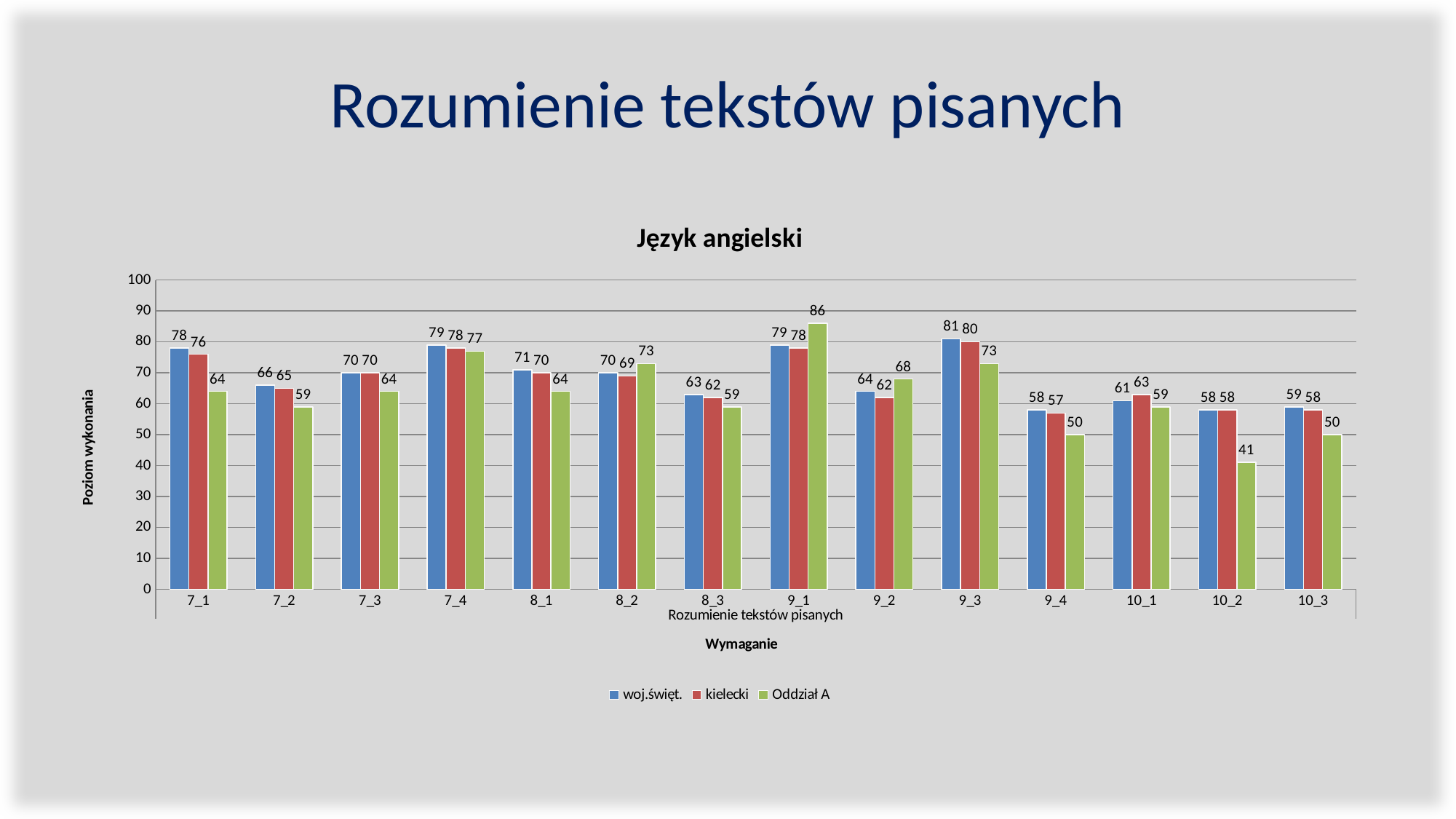
Which category has the lowest value for Oddział A? 10_2 What is the value for woj.święt. at category 9_3? 81 What is the title of the chart? Język angielski What kind of chart is shown on the slide? bar chart How many categories are shown on the x axis? 14 At category 8_2, which is larger: the kielecki value or the Oddział A value? Oddział A Which category has the highest value for Oddział A? 9_1 How many series does the legend list? 3 What is the value for Oddział A at category 9_1? 86 What is the value for kielecki at category 10_2? 58 What is the label of the y axis? Poziom wykonania What is the difference between the woj.święt. value and the Oddział A value at category 7_1? 14